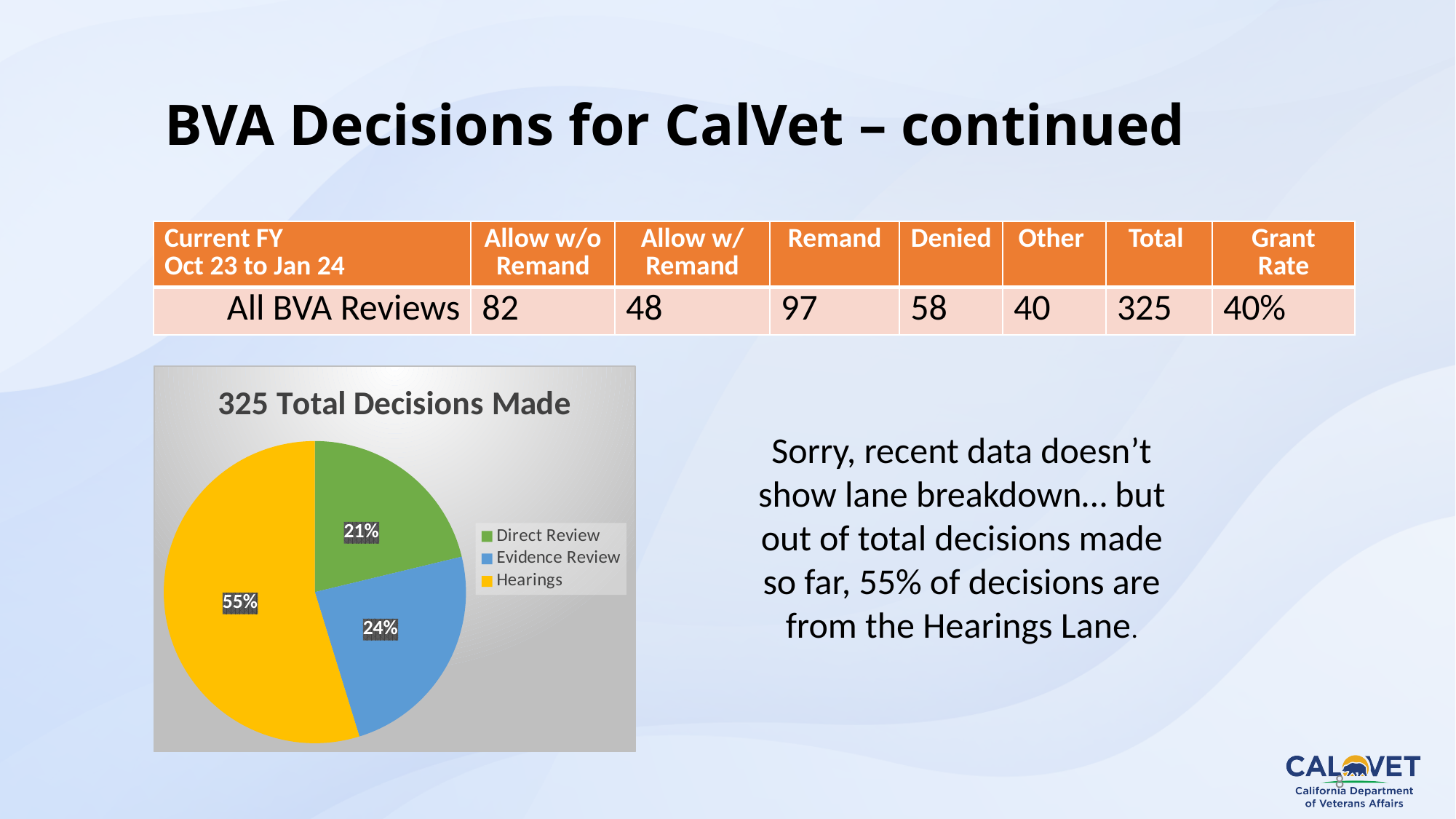
What kind of chart is shown on the slide? pie chart What share of the pie does Hearings represent? 55% What colour is the Hearings slice in the pie chart? yellow Which category has the largest slice of the pie? Hearings Which is larger, the Evidence Review slice or the Direct Review slice? Evidence Review How many entries does the legend list? 3 What share of the pie does Evidence Review represent? 24% What is the title of the pie chart? 325 Total Decisions Made How many categories does the pie chart show? 3 What is the difference in percentage points between the Hearings slice and the Evidence Review slice? 31 Which category has the smallest slice of the pie? Direct Review What share of the pie does Direct Review represent? 21%